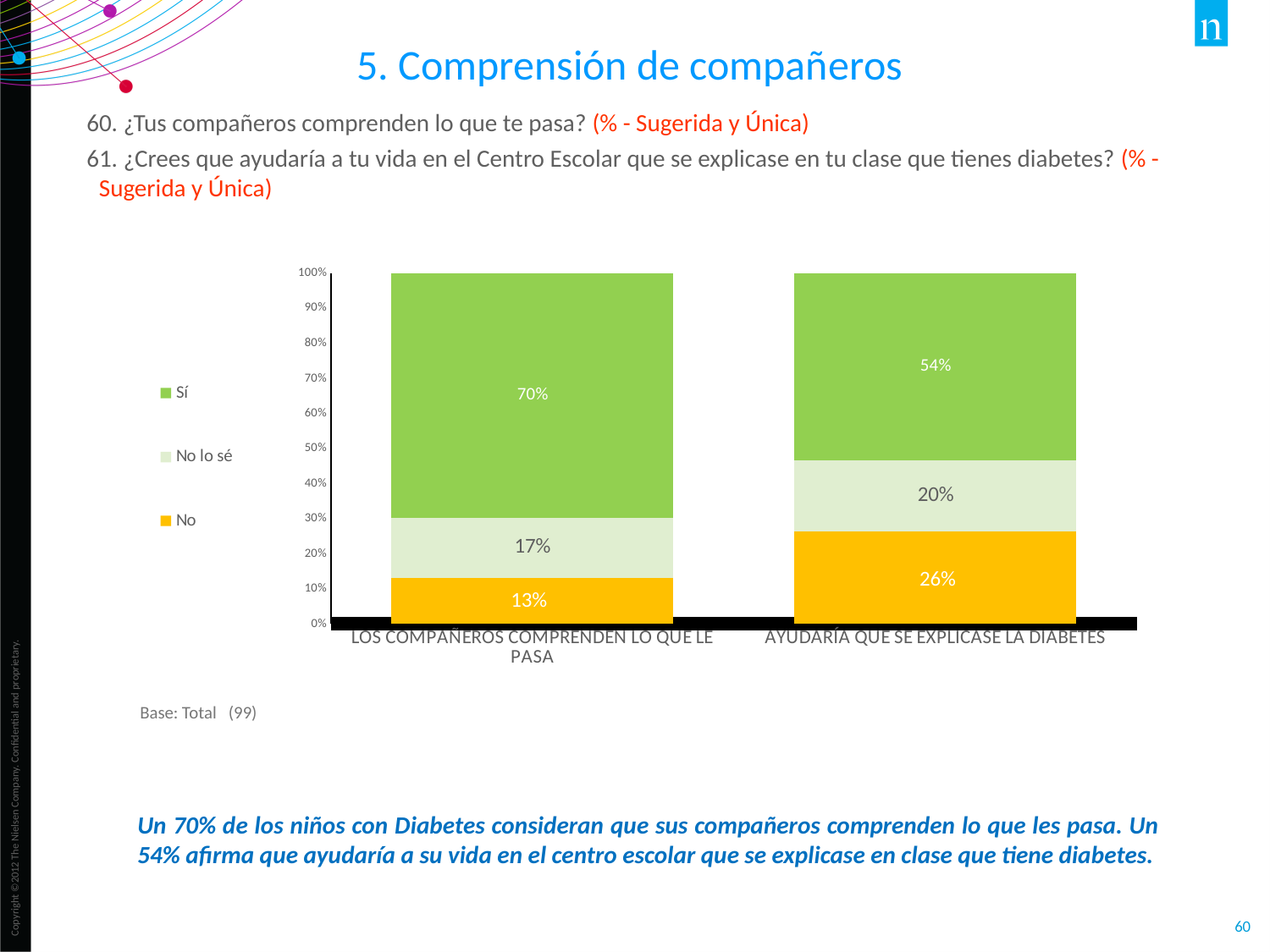
What is the difference between the "No" percentages of the two categories? 13% What percentage answered "Sí" for "AYUDARÍA QUE SE EXPLICASE LA DIABETES"? 54% Which category has the higher "Sí" percentage? LOS COMPAÑEROS COMPRENDEN LO QUE LE PASA What kind of chart is shown on the slide? Stacked bar chart Which response has the lowest percentage for "LOS COMPAÑEROS COMPRENDEN LO QUE LE PASA"? No How many series does the legend list? 3 What is the difference between the "Sí" percentages of the two categories? 16% What colour represents the "No" series in the chart? Yellow What percentage answered "No" for "AYUDARÍA QUE SE EXPLICASE LA DIABETES"? 26% How many categories are shown on the x axis? 2 What percentage answered "No lo sé" for "LOS COMPAÑEROS COMPRENDEN LO QUE LE PASA"? 17% What percentage answered "Sí" for "LOS COMPAÑEROS COMPRENDEN LO QUE LE PASA"? 70%